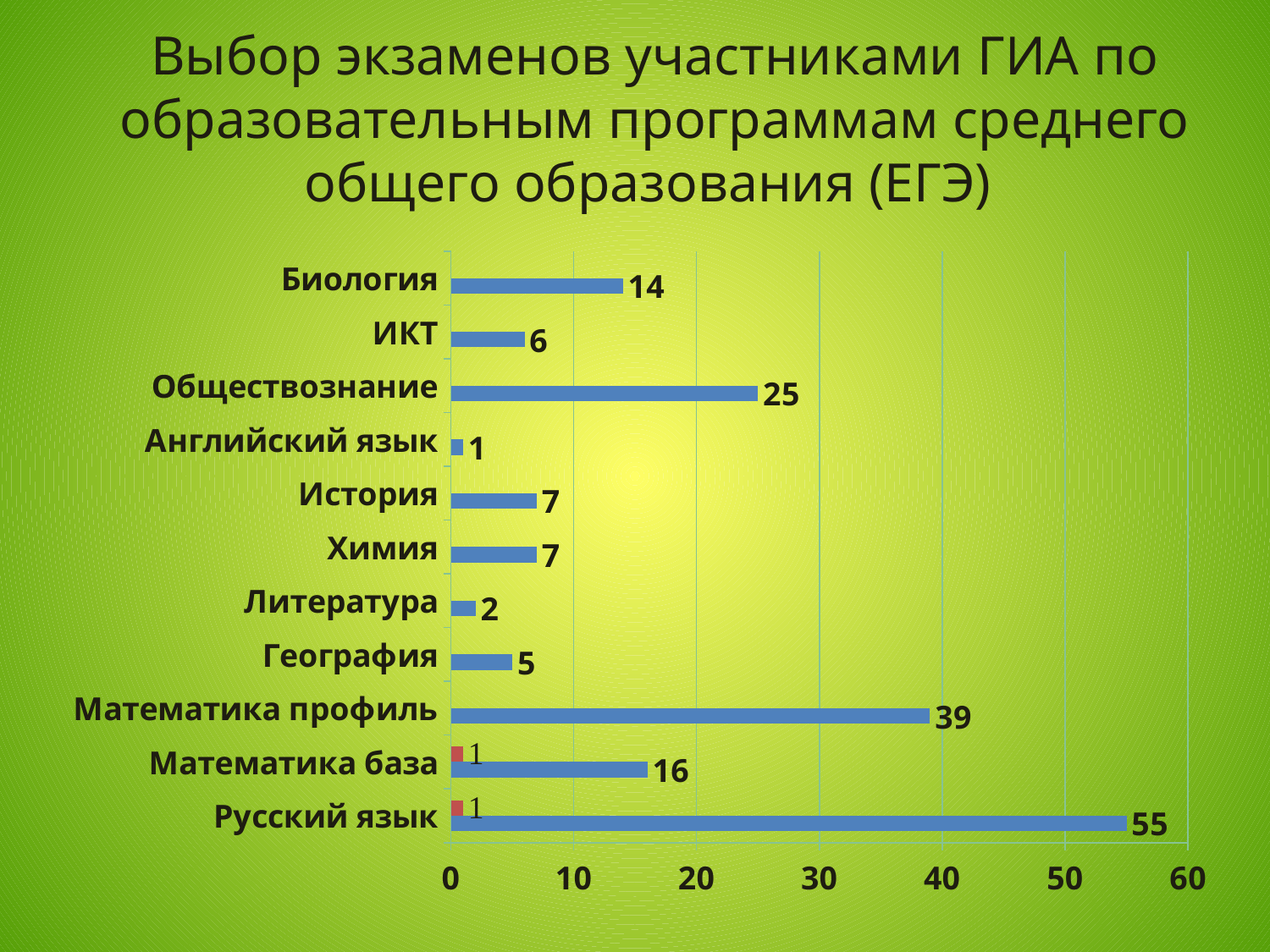
What is the value of the blue bar for Математика профиль? 39 What is the value of the blue bar for Обществознание? 25 Which categories have a red bar in addition to a blue bar? Математика база and Русский язык Which has a larger blue bar value, Биология or Обществознание? Обществознание Which category has the lowest blue bar value? Английский язык What is the value of the blue bar for Русский язык? 55 What kind of chart is shown on the slide? bar chart Which category has the highest blue bar value? Русский язык What is the value of the red bar for Математика база? 1 What is the value of the blue bar for ИКТ? 6 What is the difference between the blue bar values for Русский язык and Математика профиль? 16 How many categories are shown on the vertical axis of the chart? 11